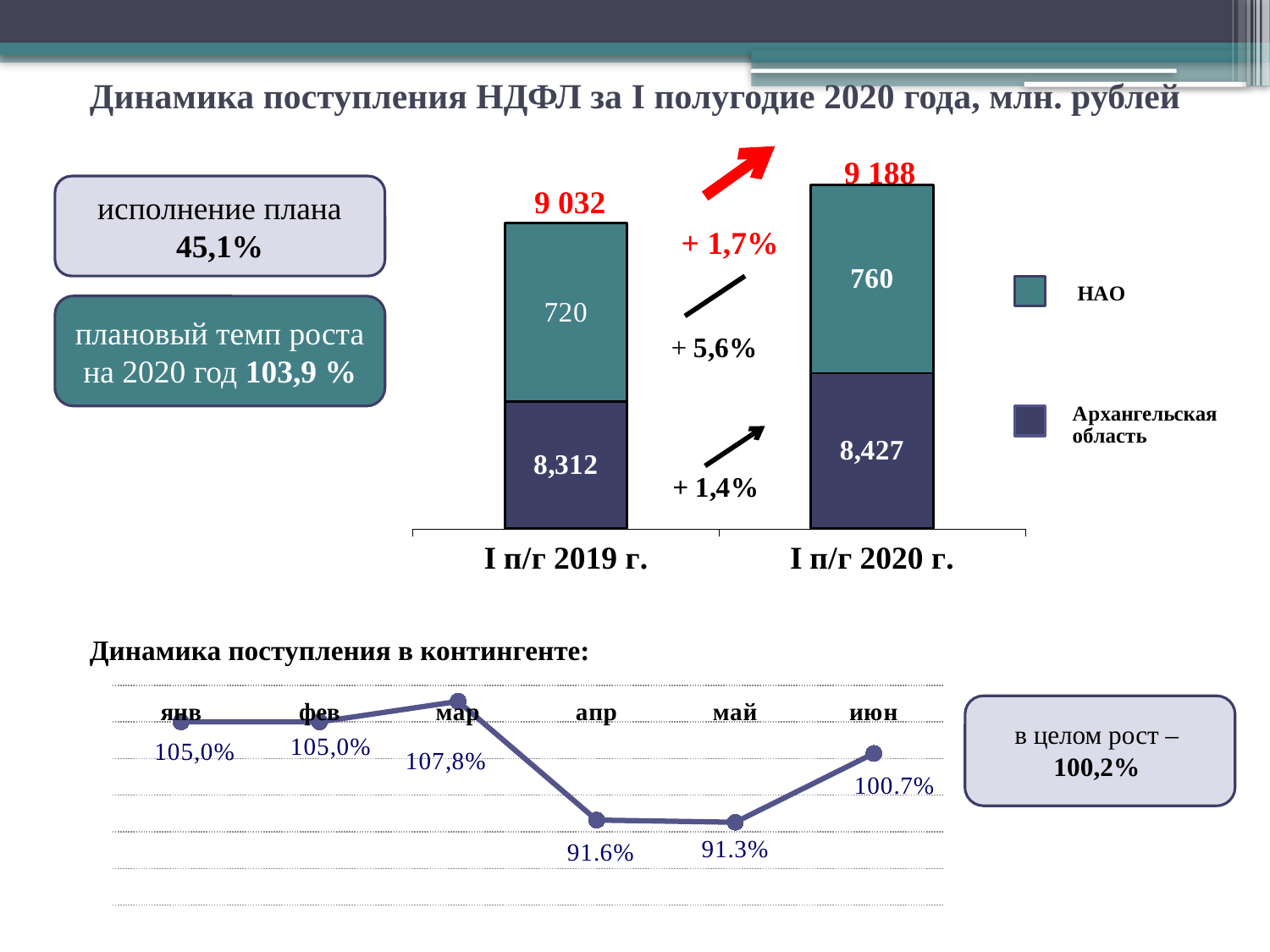
In the top stacked bar chart, how many series does the legend list? 2 In the top stacked bar chart, which series is larger in I п/г 2020 г., НАО or Архангельская область? Архангельская область In the top stacked bar chart, what is the value for Архангельская область in I п/г 2019 г.? 8,312 What kind of chart is the top chart on the slide? Stacked bar chart In the bottom line chart 'Динамика поступления в контингенте', what is the value for мар? 107,8% In the bottom line chart 'Динамика поступления в контингенте', how many months are plotted? 6 In the top stacked bar chart, what is the difference between the Архангельская область values for I п/г 2020 г. and I п/г 2019 г.? 115 In the top stacked bar chart, what is the value for НАО in I п/г 2020 г.? 760 In the bottom line chart 'Динамика поступления в контингенте', which month has the highest value? мар In the top stacked bar chart, what is the total of the I п/г 2020 г. bar? 9 188 In the top stacked bar chart, what is the total of the I п/г 2019 г. bar? 9 032 In the bottom line chart 'Динамика поступления в контингенте', which month has the lowest value? май